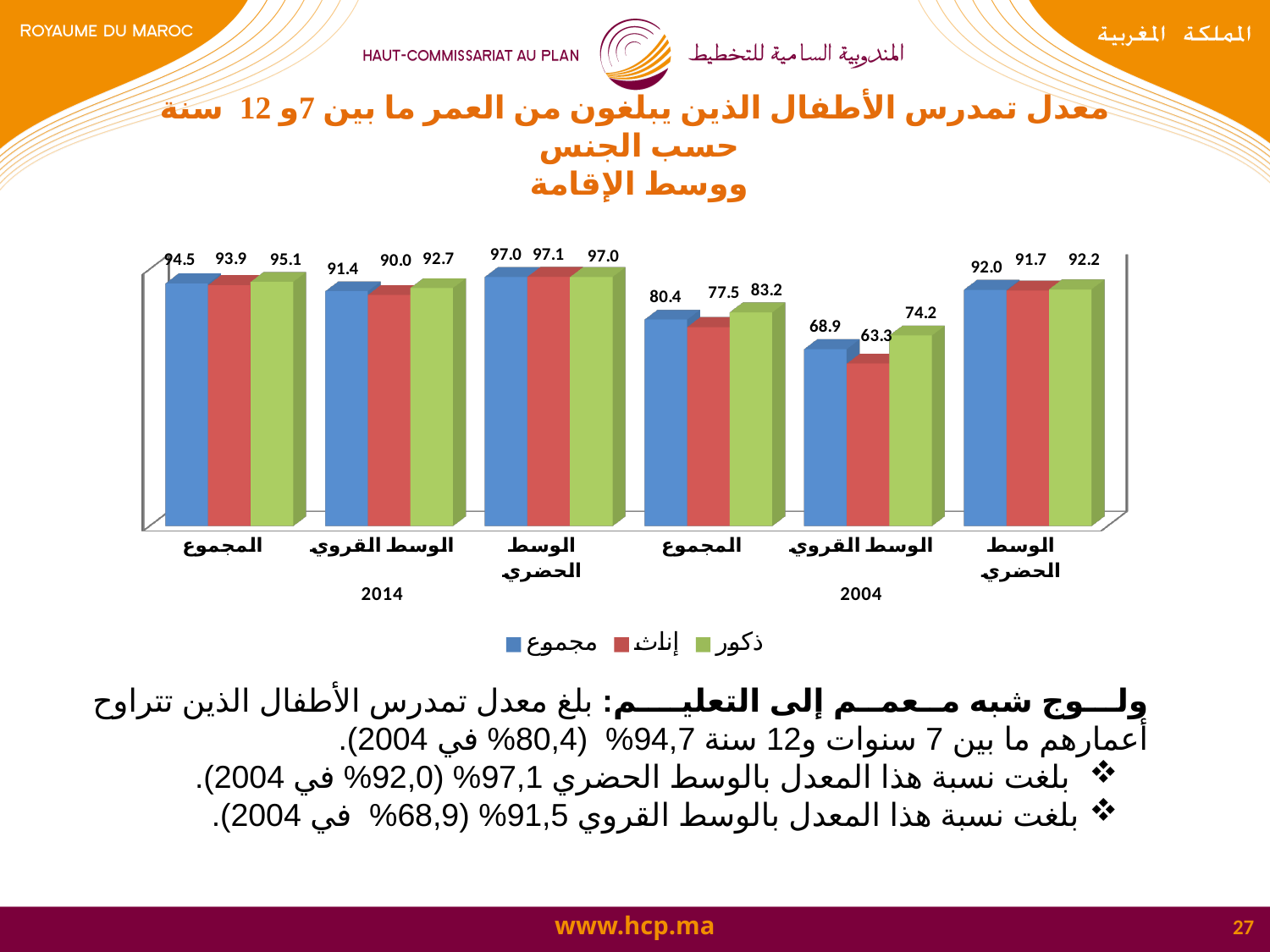
What is the difference between the blue (مجموع) values for الوسط القروي in 2014 and in 2004? 22.5 What is the value of the blue (مجموع) bar for الوسط القروي in 2014? 91.4 What is the value of the red (إناث) bar for الوسط الحضري in 2014? 97.1 What kind of chart is shown on the slide? Bar chart How many series does the legend list? 3 Which is larger: the green (ذكور) value for المجموع in 2004 or the red (إناث) value for المجموع in 2004? ذكور (83.2) Which category group has the highest green (ذكور) value? الوسط الحضري 2014 What is the value of the red (إناث) bar for الوسط القروي in 2004? 63.3 What is the value of the green (ذكور) bar for المجموع in 2004? 83.2 Which series is shown in green in the legend? ذكور How many category groups are shown on the x axis? 6 Which category group has the lowest red (إناث) value? الوسط القروي 2004